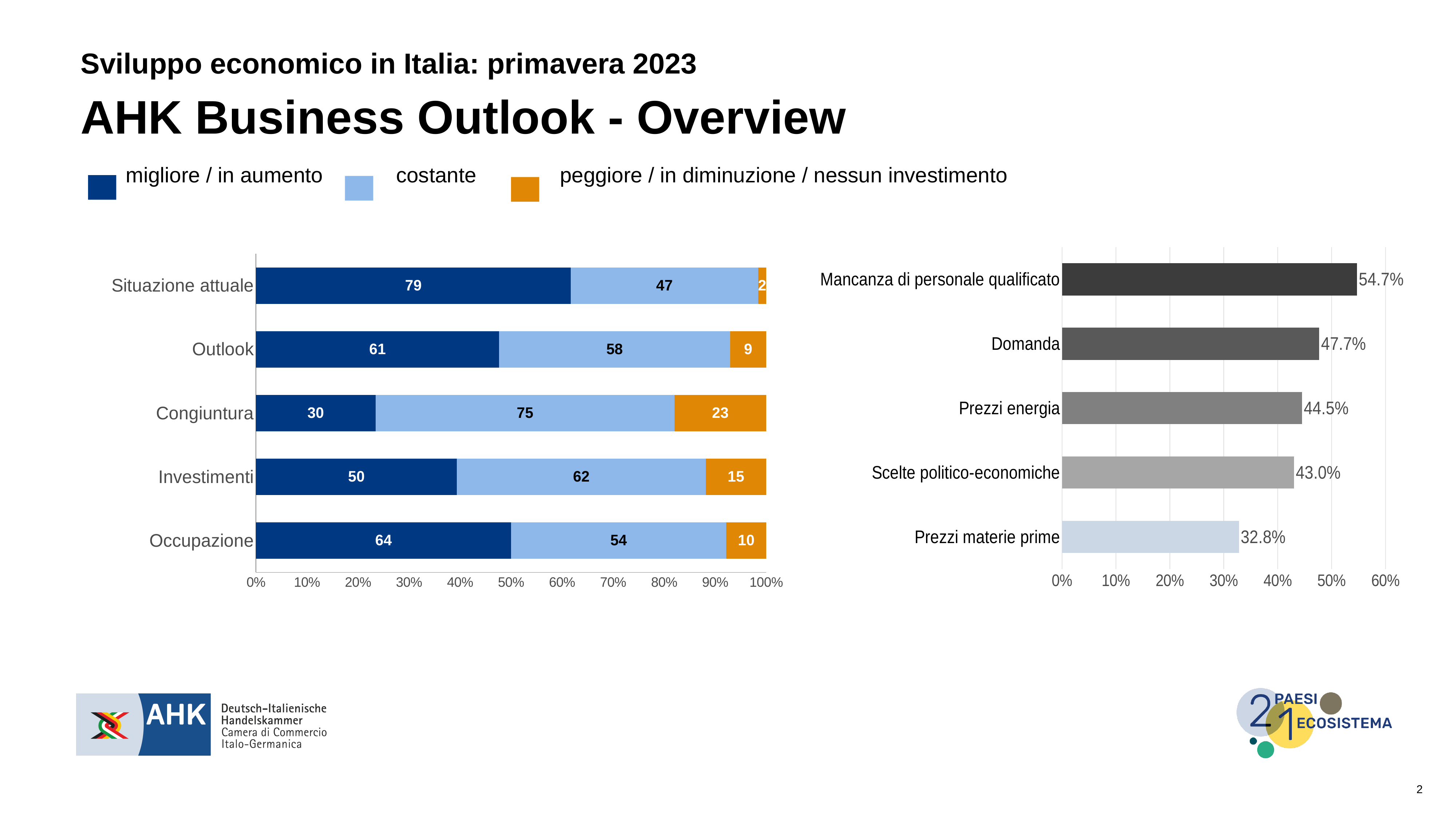
In the left stacked bar chart, what is the 'migliore / in aumento' value for Situazione attuale? 79 In the right bar chart, what is the value for Prezzi energia? 44.5% In the right bar chart, is the value for Domanda larger or smaller than the value for Scelte politico-economiche? larger In the left stacked bar chart, which category has the lowest 'migliore / in aumento' value? Congiuntura How many categories are shown in the right bar chart? 5 In the left stacked bar chart, what is the difference between the 'migliore / in aumento' values for Occupazione and Outlook? 3 In the left stacked bar chart, which category has the highest 'peggiore / in diminuzione / nessun investimento' value? Congiuntura In the left stacked bar chart, what is the 'costante' value for Congiuntura? 75 How many series does the legend of the left stacked bar chart list? 3 In the left stacked bar chart, what is the 'peggiore / in diminuzione / nessun investimento' value for Investimenti? 15 In the right bar chart, which category has the lowest value? Prezzi materie prime In the left stacked bar chart, what is the total of the three values for Outlook? 128